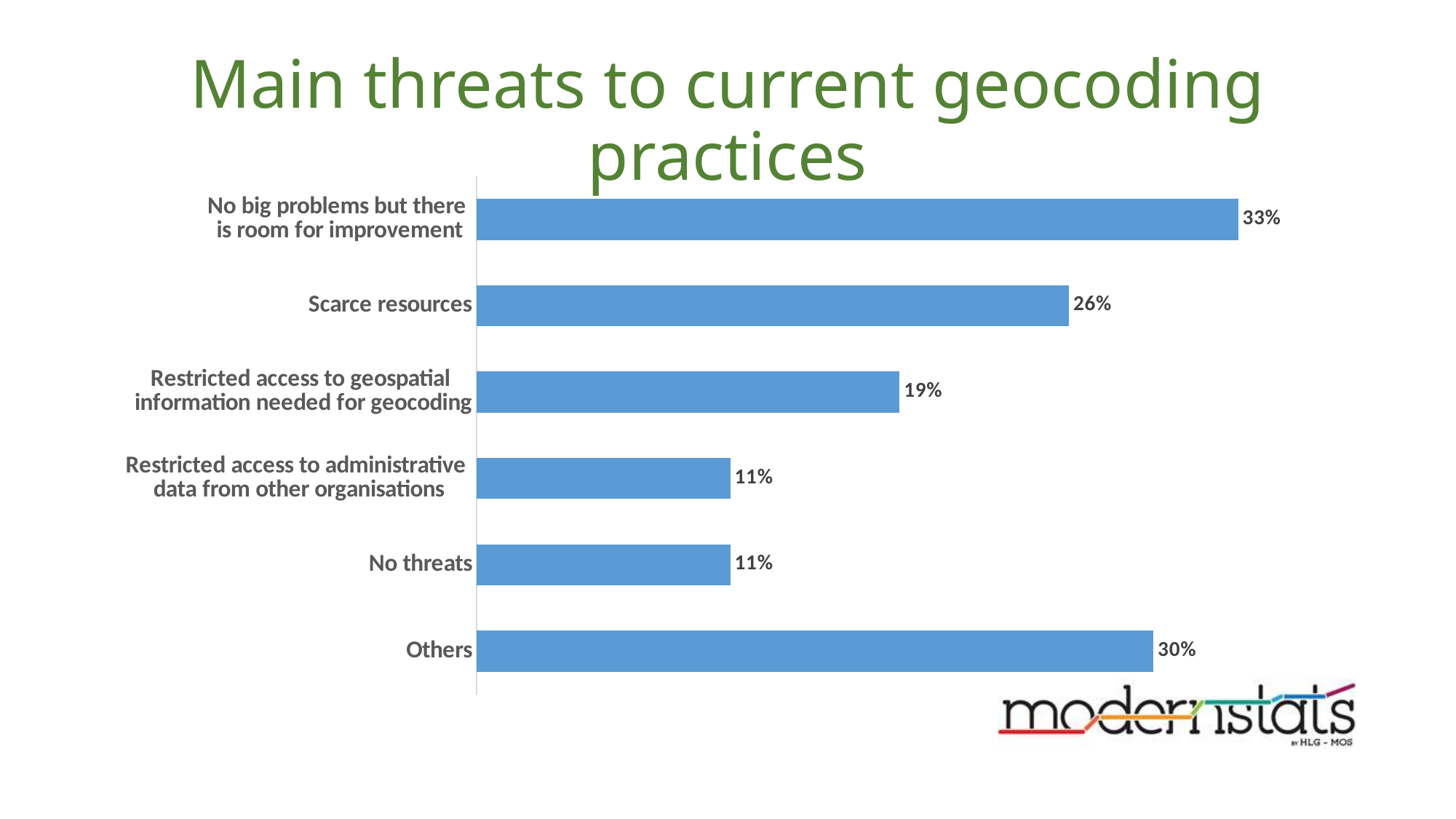
How many categories are shown in the chart? 6 What is the difference between the values for "Others" and "Restricted access to geospatial information needed for geocoding"? 11% What is the title of the slide? Main threats to current geocoding practices What is the value for "Restricted access to geospatial information needed for geocoding"? 19% Which is larger, the value for "Restricted access to geospatial information needed for geocoding" or the value for "Restricted access to administrative data from other organisations"? Restricted access to geospatial information needed for geocoding Which category has the highest value? No big problems but there is room for improvement What is the difference between the values for "No big problems but there is room for improvement" and "Scarce resources"? 7% What is the value for "No threats"? 11% What kind of chart is shown on the slide? Bar chart What is the value for "Scarce resources"? 26% Which is larger, the value for "Others" or the value for "Scarce resources"? Others What is the value for "Others"? 30%